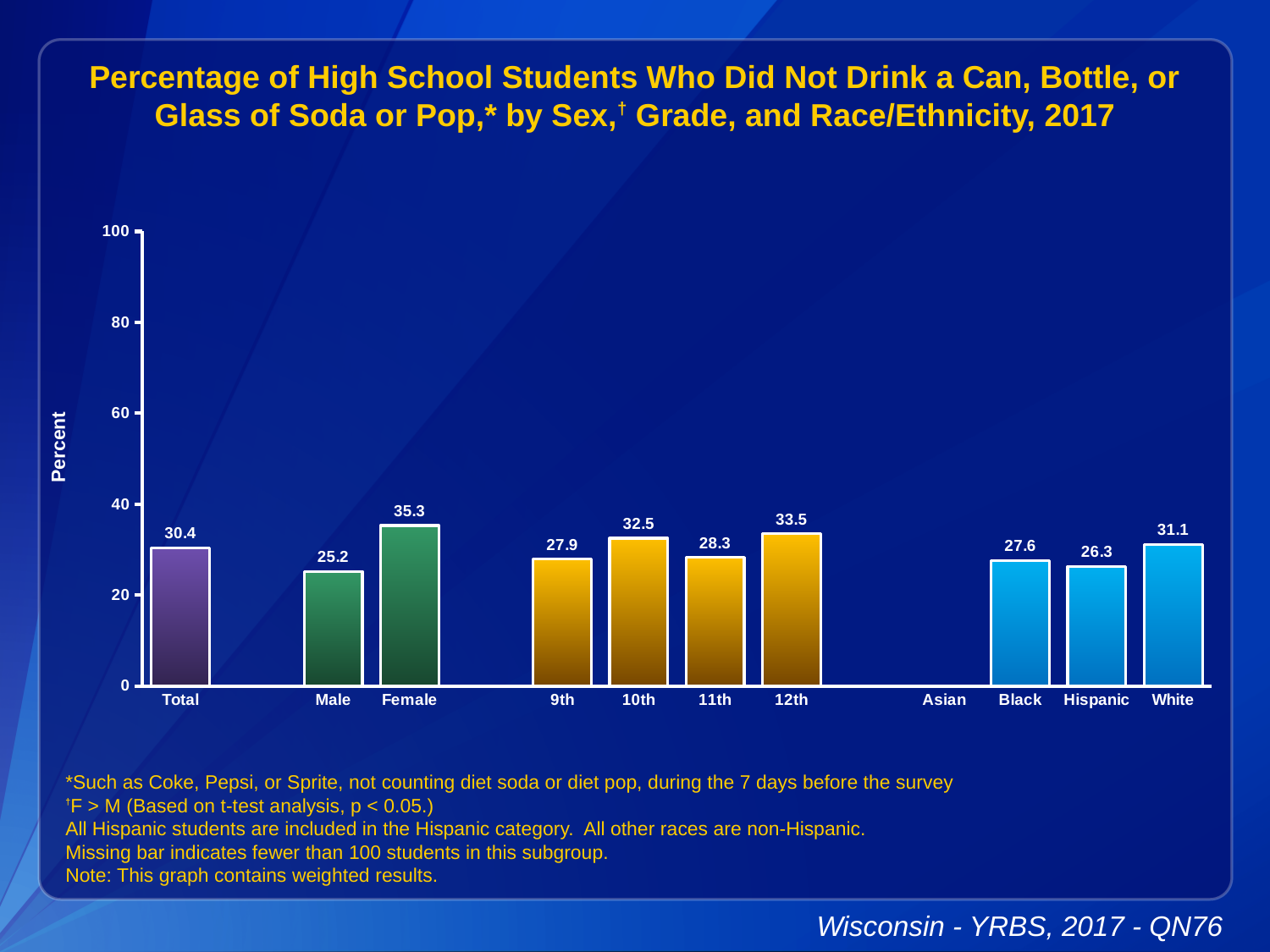
Which is larger, the value for 10th grade or the value for 11th grade? 10th Which category on the x axis has no bar plotted? Asian What kind of chart is shown? bar chart How many categories have a plotted bar? 11 Which category with a plotted bar has the lowest value? Male What is the value for Total? 30.4 Which category has the highest value? Female What is the value for 12th grade? 33.5 What is the difference between the Female and Male values? 10.1 Is the value for White greater or less than 40? less What is the value for Female? 35.3 What is the value for Hispanic? 26.3